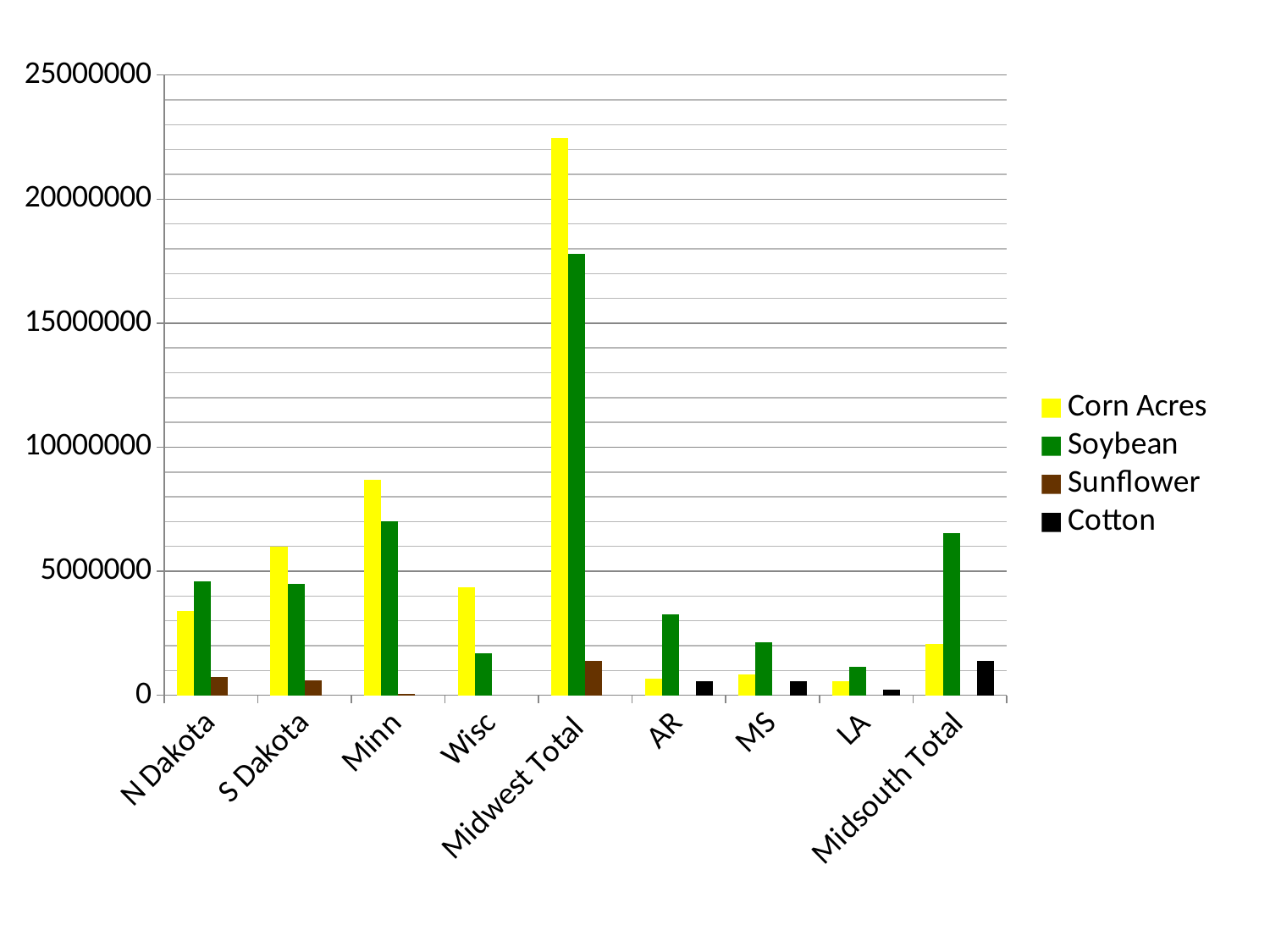
For Minn, which is larger: Corn Acres or Soybean? Corn Acres Is the Corn Acres value for Midwest Total greater or less than 20000000? greater Is the Corn Acres value for Wisc greater or less than 5000000? less Which category has the highest Corn Acres value? Midwest Total How many series does the legend list? 4 Is the Soybean value for Midwest Total greater or less than 15000000? greater How many categories are shown along the x axis? 9 Which category has the highest Soybean value? Midwest Total For Midsouth Total, which is larger: Corn Acres or Soybean? Soybean What colour represents the Cotton series in the legend? black What kind of chart is shown on the slide? bar chart